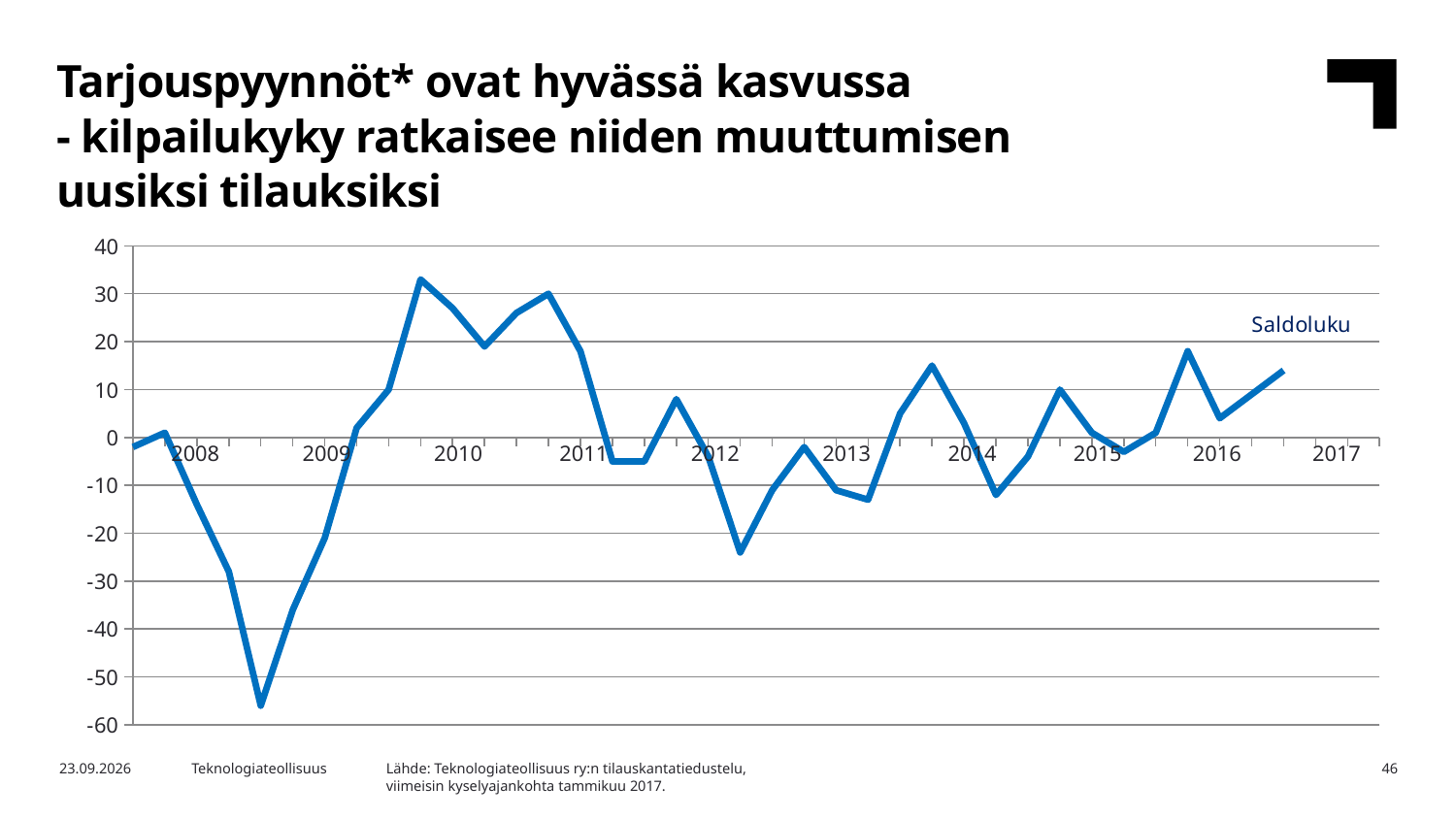
Is the final point of the line (in 2017) greater or less than 10? greater Is the lowest point of the line greater or less than -50? less Is the lowest point of the line above or below the 0 line? below How many year labels are shown along the x axis? 10 Does the line rise or fall between the 2016 label and the end of the line? rise Is the final point of the line (in 2017) greater or less than 20? less How many series does the chart plot? 1 What is the highest value shown on the y axis? 40 Is the peak of the line around 2010 higher or lower than the peak around 2016? higher What kind of chart is shown on the slide? line chart What is the name of the series shown on the chart? Saldoluku